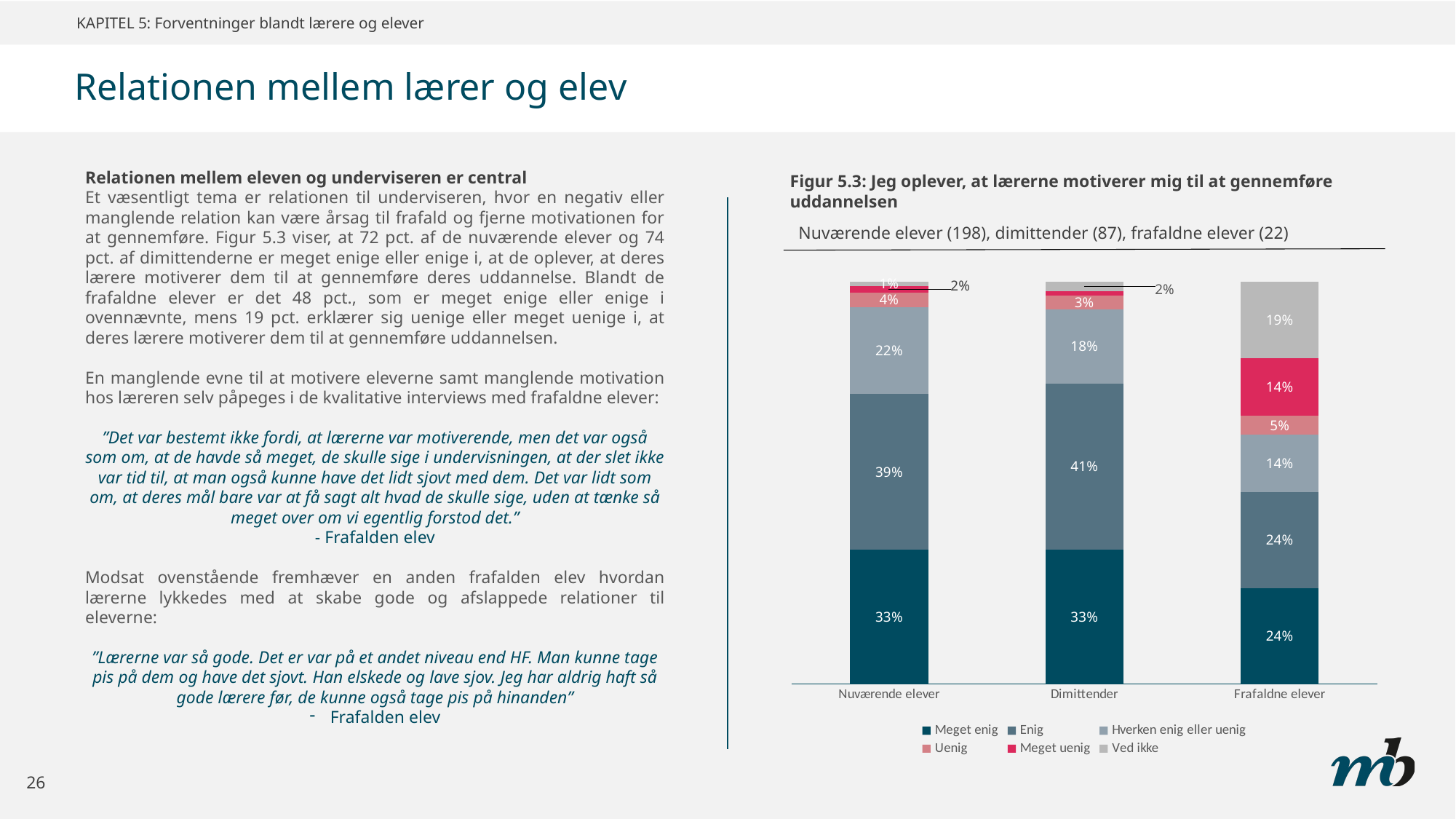
Which is larger: 'Hverken enig eller uenig' for Nuværende elever or for Dimittender? Nuværende elever What is the value for 'Hverken enig eller uenig' among Nuværende elever? 22% What is the value for 'Enig' among Dimittender? 41% What kind of chart is shown in Figur 5.3? Stacked bar chart How many series does the chart legend list? 6 How many categories are shown on the x axis of the chart? 3 According to the chart subtitle, how many Dimittender responded? 87 What is the value for 'Ved ikke' among Frafaldne elever? 19% What is the difference between the 'Enig' values for Dimittender and Frafaldne elever? 17% What is the value for 'Meget uenig' among Frafaldne elever? 14% Which category has the lowest value for 'Meget enig'? Frafaldne elever What is the value for 'Meget enig' among Nuværende elever? 33%